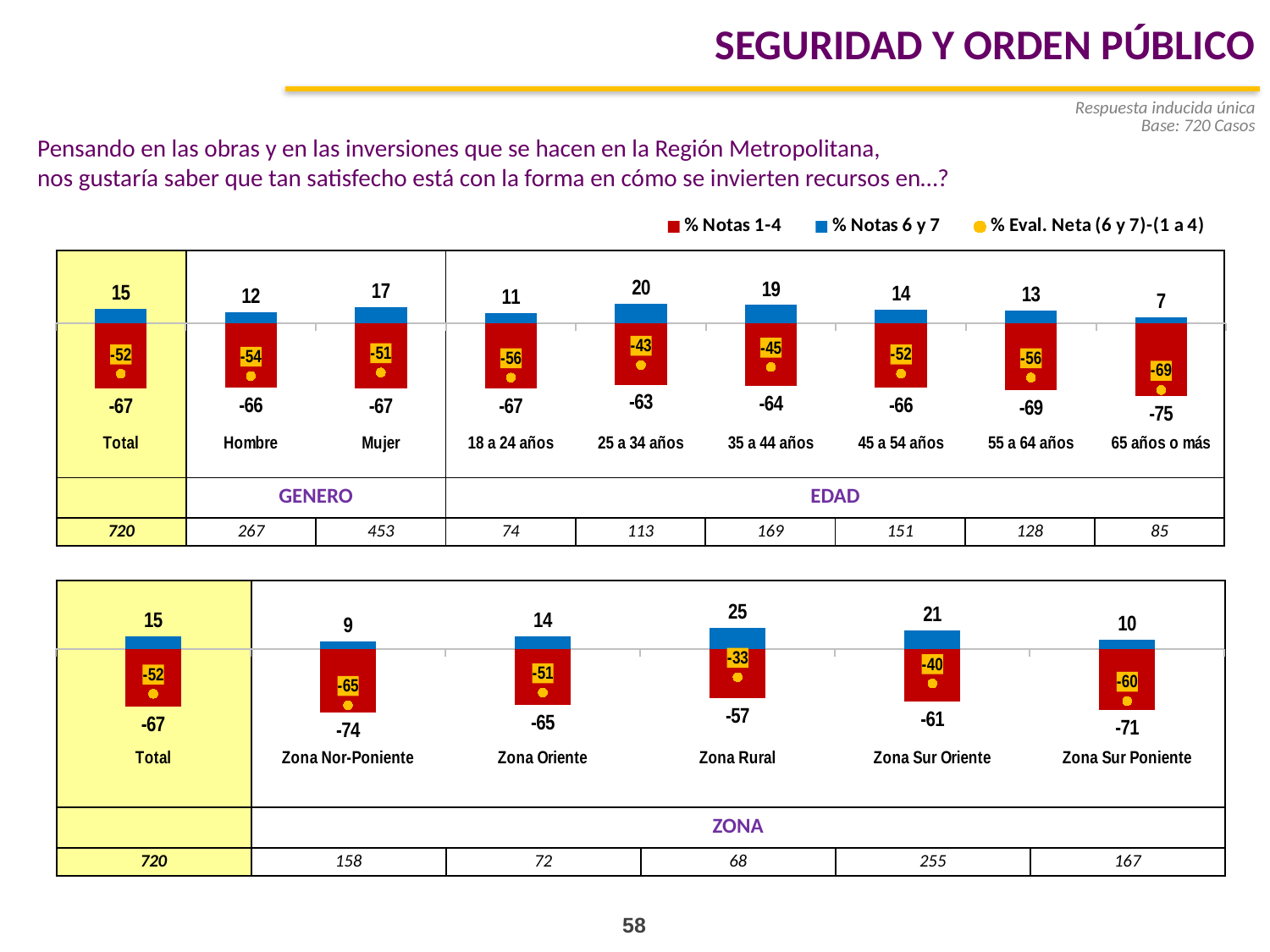
In the top chart, what is the % Notas 6 y 7 value for Mujer? 17 How many series does the legend list? 3 How many zone categories (excluding Total) are shown in the bottom chart? 5 In the bottom chart, what is the % Notas 6 y 7 value for Zona Rural? 25 In the top chart, what is the % Notas 1-4 value for 65 años o más? -75 In the bottom chart, which is larger in % Notas 6 y 7: Zona Sur Oriente or Zona Sur Poniente? Zona Sur Oriente In the top chart, which age group has the highest % Notas 6 y 7 value? 25 a 34 años In the top chart, which age group has the lowest % Notas 6 y 7 value? 65 años o más In the bottom chart, which zone has the highest % Notas 6 y 7 value? Zona Rural In the top chart, what is the % Eval. Neta value for 25 a 34 años? -43 In the bottom chart, what is the % Eval. Neta value for Zona Nor-Poniente? -65 In the top chart, what is the difference between the % Notas 6 y 7 values for Mujer and Hombre? 5